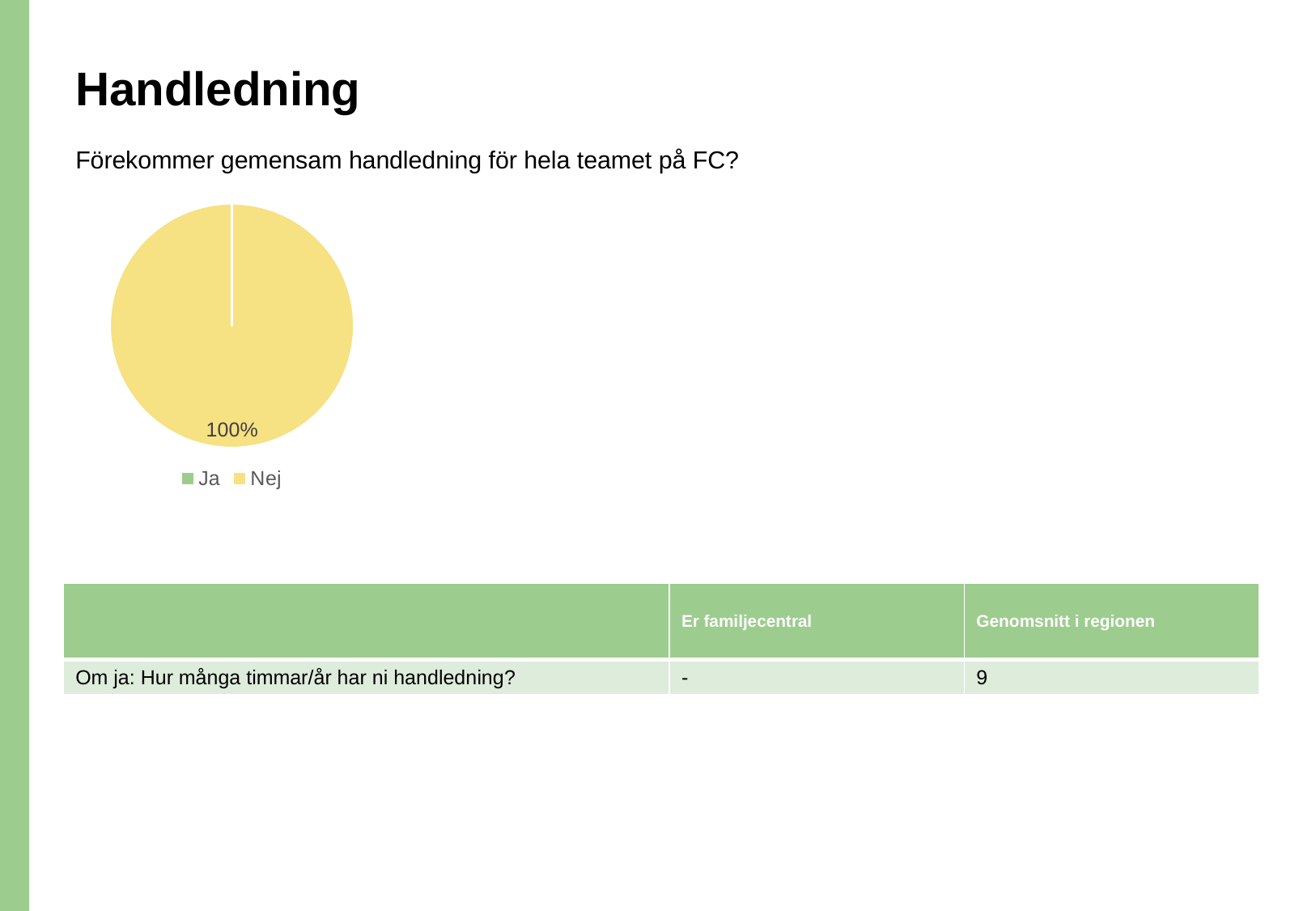
How many entries does the legend of the pie chart list? 2 What question does the pie chart answer, according to the text above it? Förekommer gemensam handledning för hela teamet på FC? What kind of chart is shown on the slide? pie chart What share of the pie does the Nej slice represent? 100% Which is larger in the pie chart, Ja or Nej? Nej Which category has the smaller share of the pie, Ja or Nej? Ja What colour is the Nej slice in the pie chart? yellow What is the only percentage label printed on the pie chart? 100% Which category has the largest share of the pie? Nej